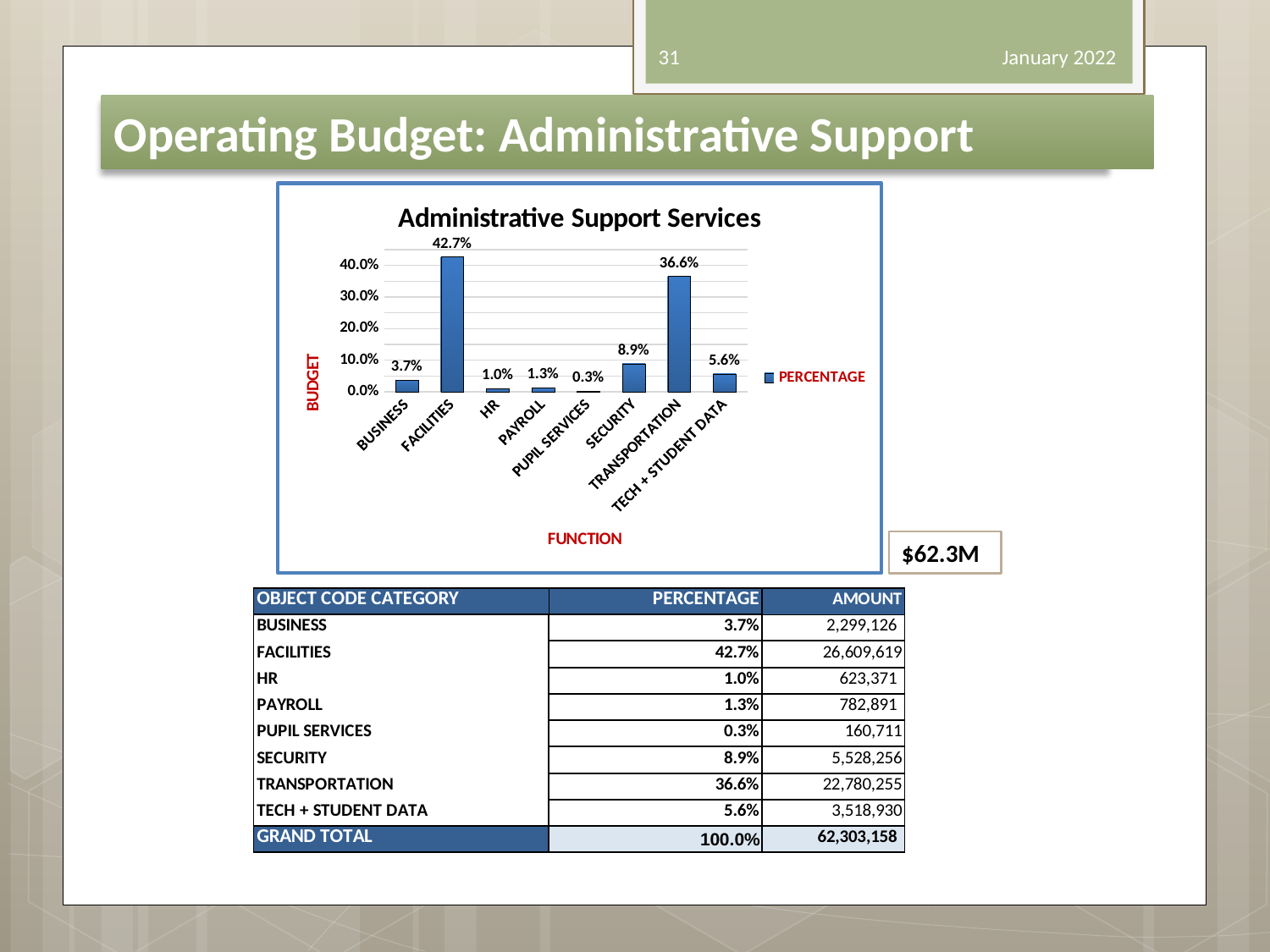
How many categories are shown on the x axis of the Administrative Support Services chart? 8 Is the value for TRANSPORTATION in the Administrative Support Services chart greater or less than 30.0%? greater What is the x-axis title of the Administrative Support Services chart? FUNCTION What is the value for SECURITY in the Administrative Support Services chart? 8.9% Which is larger in the Administrative Support Services chart, SECURITY or TECH + STUDENT DATA? SECURITY What is the value for PUPIL SERVICES in the Administrative Support Services chart? 0.3% Which category has the lowest value in the Administrative Support Services chart? PUPIL SERVICES What is the difference between the values for FACILITIES and TRANSPORTATION in the Administrative Support Services chart? 6.1% Which category has the highest value in the Administrative Support Services chart? FACILITIES What is the value for FACILITIES in the Administrative Support Services chart? 42.7% What kind of chart is the Administrative Support Services chart? bar chart How many series does the legend of the Administrative Support Services chart list? 1